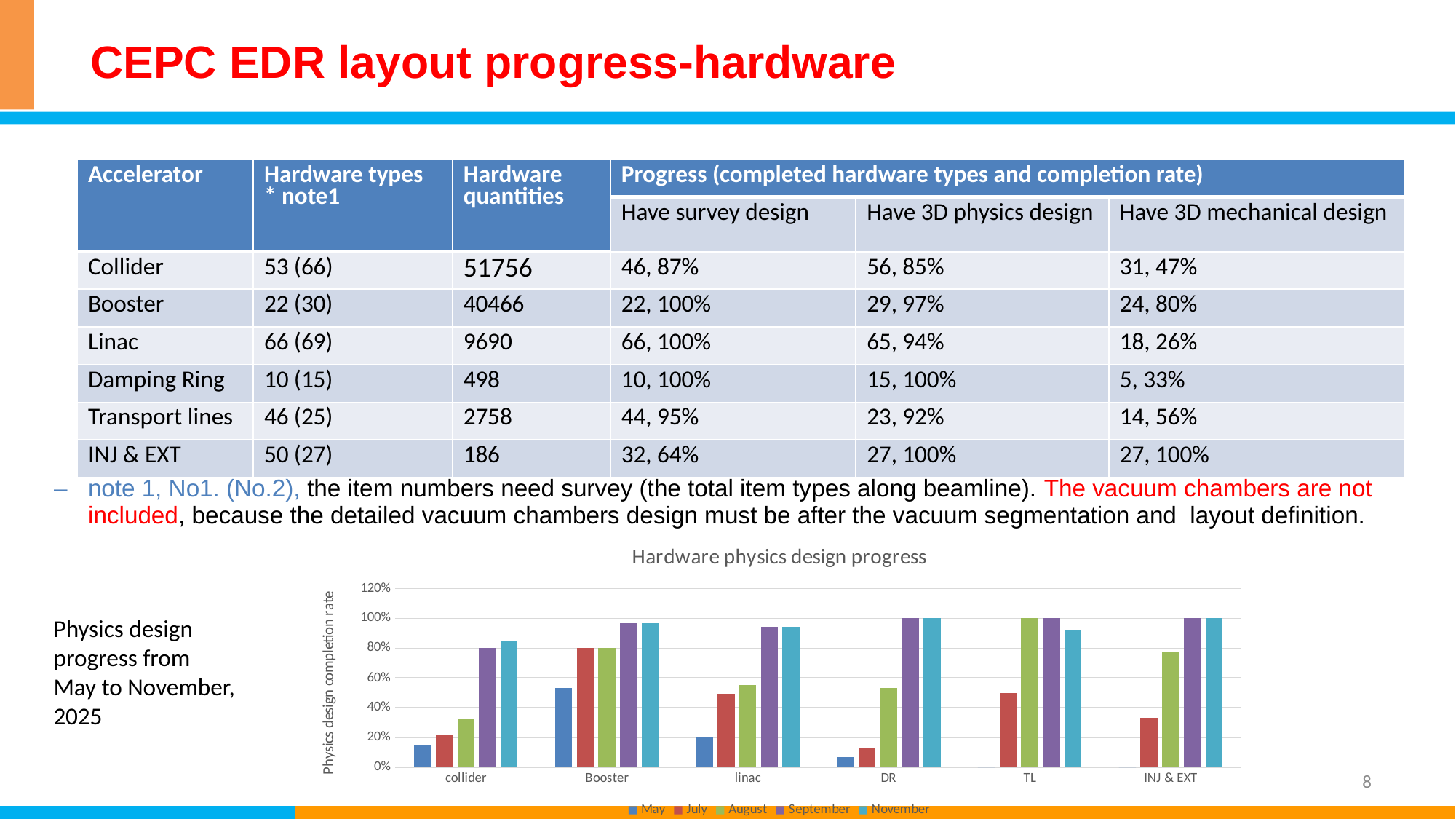
Which is larger, the July value for DR or the July value for TL? TL Which category has the highest value in July? Booster What kind of chart is shown on the slide? bar chart What is the value for TL in August? 100% Do the collider values rise or fall from May to November? rise Is the value for Booster in May greater or less than 40%? greater How many series does the chart legend list? 5 How many categories are shown on the x axis of the chart? 6 What is the value for DR in November? 100% Is the value for collider in May greater or less than 20%? less What is the y-axis label of the chart? Physics design completion rate What is the title of the chart? Hardware physics design progress